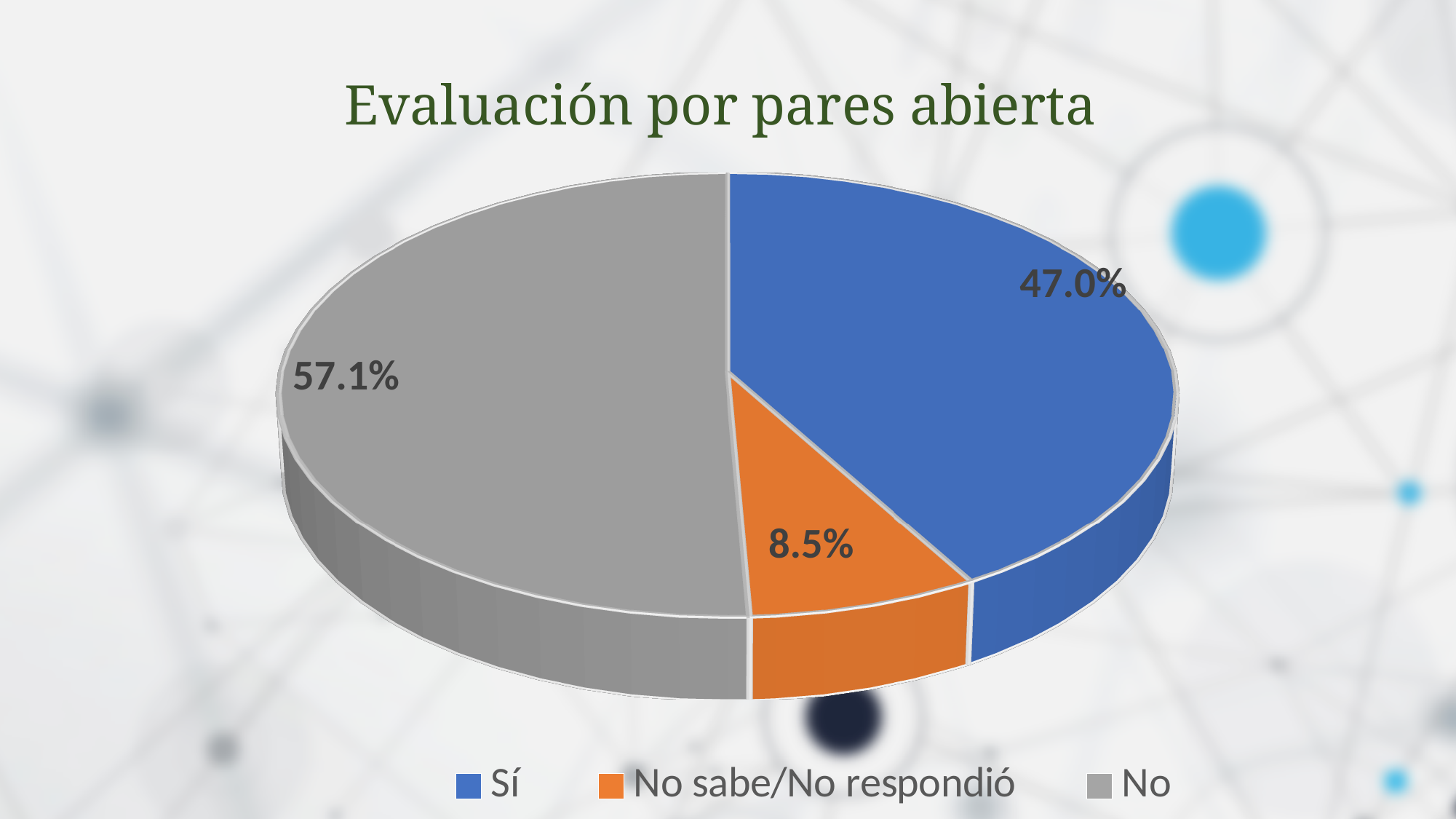
What type of chart is shown on the slide? Pie chart What colour is used for the 'No sabe/No respondió' slice? Orange Which category has the largest slice of the pie? No Which is larger, the 'Sí' slice or the 'No' slice? No Which category has the smallest slice of the pie? No sabe/No respondió What percentage is shown for the 'Sí' slice? 47.0% What is the difference in percentage points between the 'Sí' slice and the 'No sabe/No respondió' slice? 38.5 How many categories does the legend list? 3 What percentage is shown for the 'No' slice? 57.1% What is the difference in percentage points between the 'No' slice and the 'Sí' slice? 10.1 What percentage is shown for the 'No sabe/No respondió' slice? 8.5% What is the title of the chart? Evaluación por pares abierta